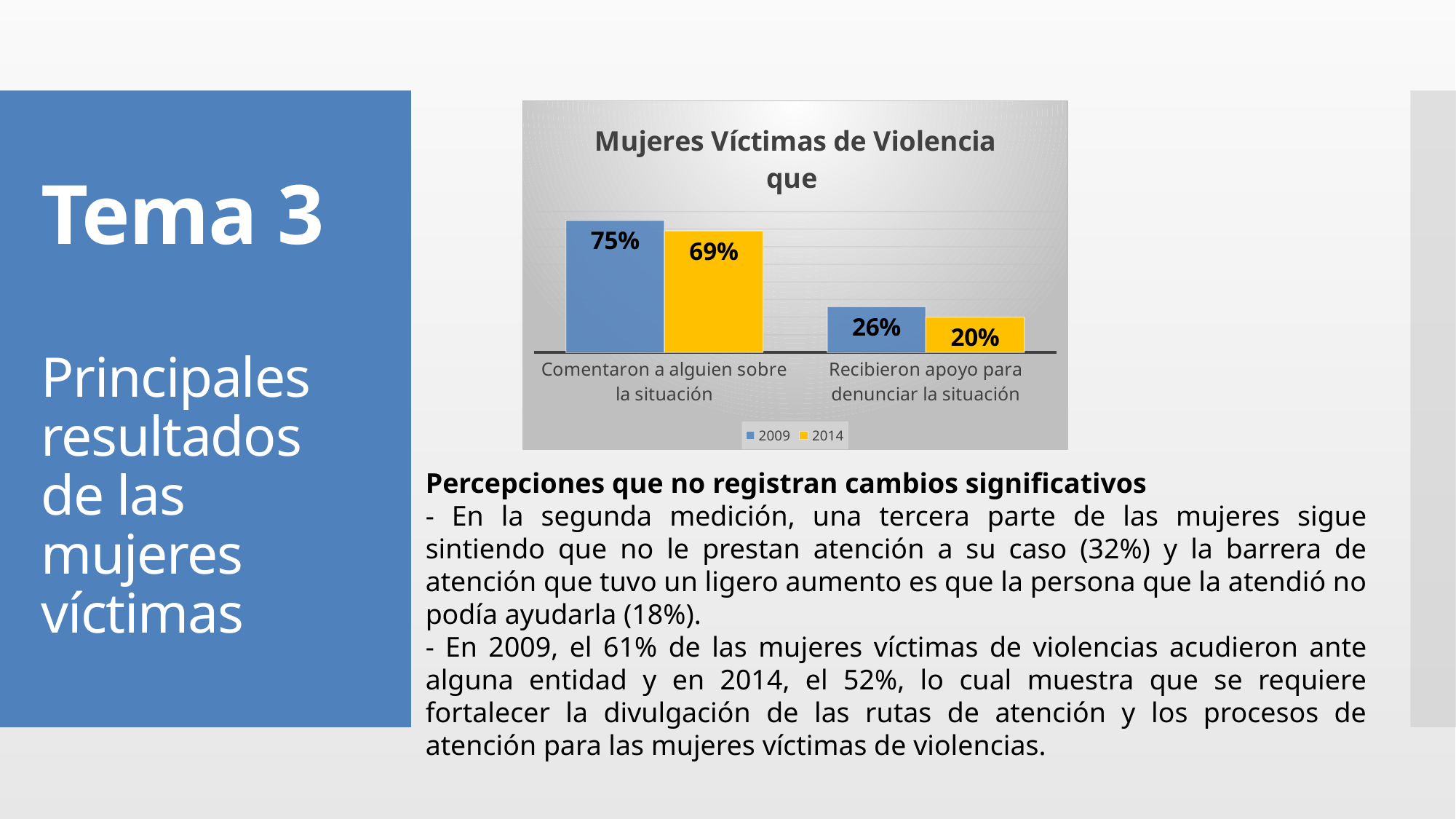
Which is larger for 'Recibieron apoyo para denunciar la situación': the 2009 value or the 2014 value? 2009 What kind of chart is shown on the slide? Bar chart What is the difference between the 2009 and 2014 values for 'Comentaron a alguien sobre la situación'? 6% What is the 2014 value for 'Recibieron apoyo para denunciar la situación'? 20% How many series does the legend list? 2 What is the 2014 value for 'Comentaron a alguien sobre la situación'? 69% What is the 2009 value for 'Recibieron apoyo para denunciar la situación'? 26% What is the 2009 value for 'Comentaron a alguien sobre la situación'? 75% Which category has the highest 2009 value? Comentaron a alguien sobre la situación How many categories are shown on the x axis? 2 What is the difference between the 2009 and 2014 values for 'Recibieron apoyo para denunciar la situación'? 6% Which category has the lowest 2014 value? Recibieron apoyo para denunciar la situación